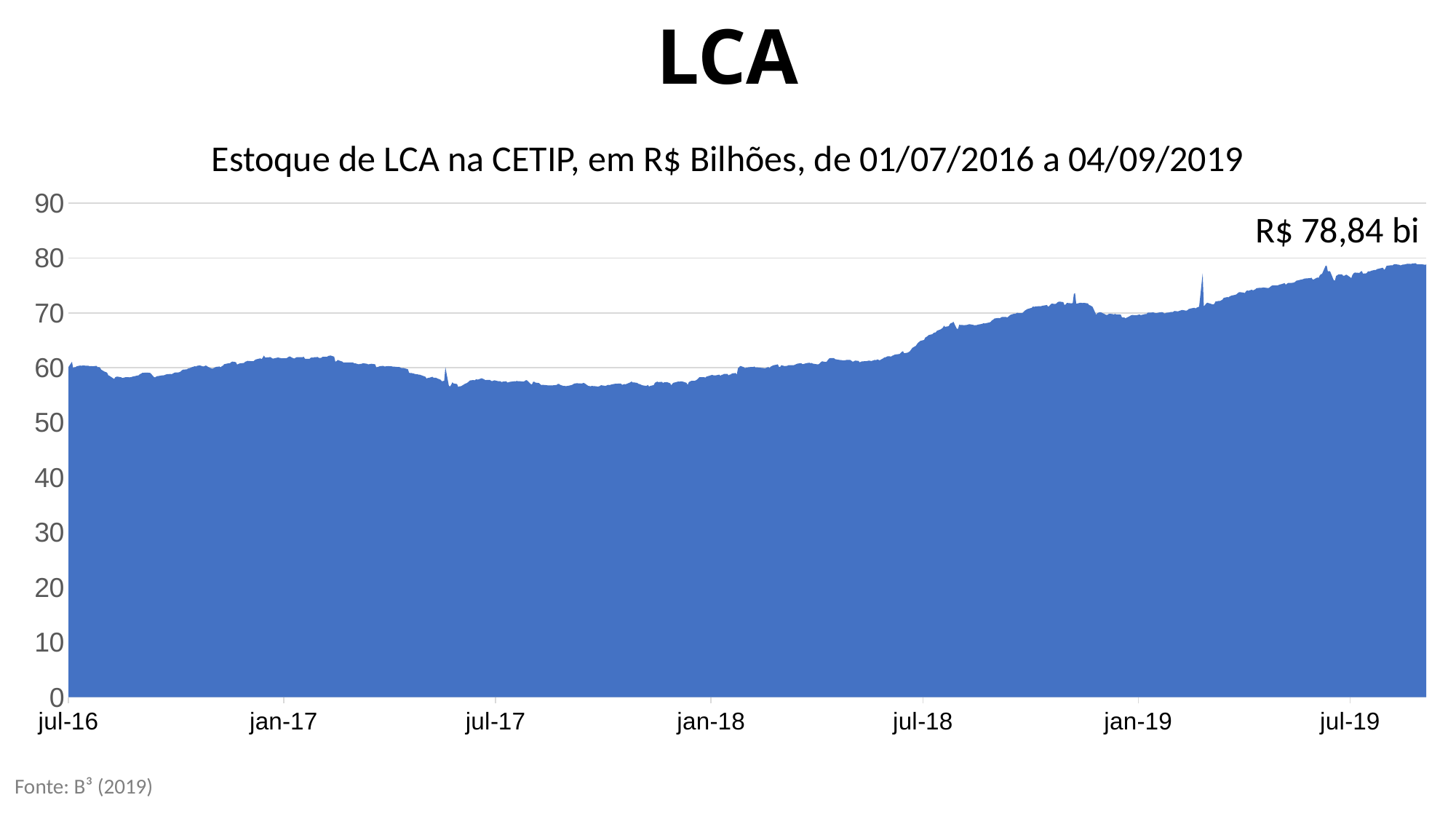
Is the value for jul-19 greater or less than 70? greater At which labelled point on the x axis is the LCA stock highest? jul-19 Overall, does the LCA stock rise or fall from jul-16 to the end of the series? rise How many date labels are shown on the x axis? 7 What is the value of the LCA stock at the end of the series (04/09/2019), as labelled on the chart? R$ 78,84 bi What is the title of the chart? Estoque de LCA na CETIP, em R$ Bilhões, de 01/07/2016 a 04/09/2019 What kind of chart is shown on the slide? area chart Does the LCA stock rise or fall between jan-17 and jul-17? fall Is the value for jul-17 greater or less than 60? less Is the value for jul-18 greater or less than 60? greater Which is larger, the value at jul-17 or the value at jul-19? jul-19